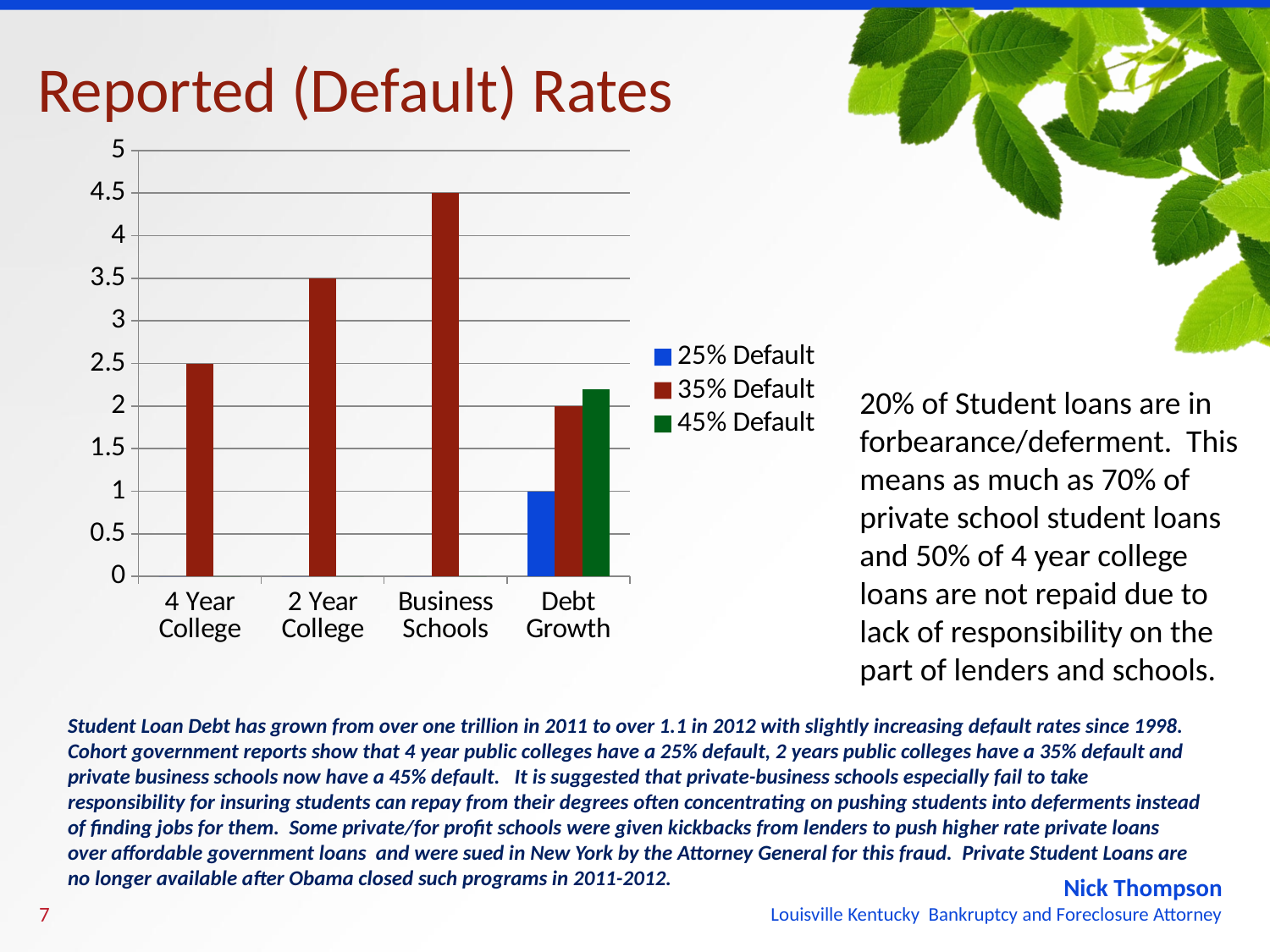
What is the 35% Default value for 4 Year College? 2.5 What is the title of the chart? Reported (Default) Rates How many series does the legend list? 3 What is the 35% Default value for Business Schools? 4.5 What kind of chart is shown on the slide? bar chart Which category has the lowest 35% Default value? Debt Growth Which category has the highest 35% Default value? Business Schools What is the 25% Default value for Debt Growth? 1 Is the 45% Default value for Debt Growth greater or less than 3? less How many categories are shown on the x axis? 4 What is the difference between the 35% Default values for Business Schools and 4 Year College? 2 What is the 35% Default value for 2 Year College? 3.5